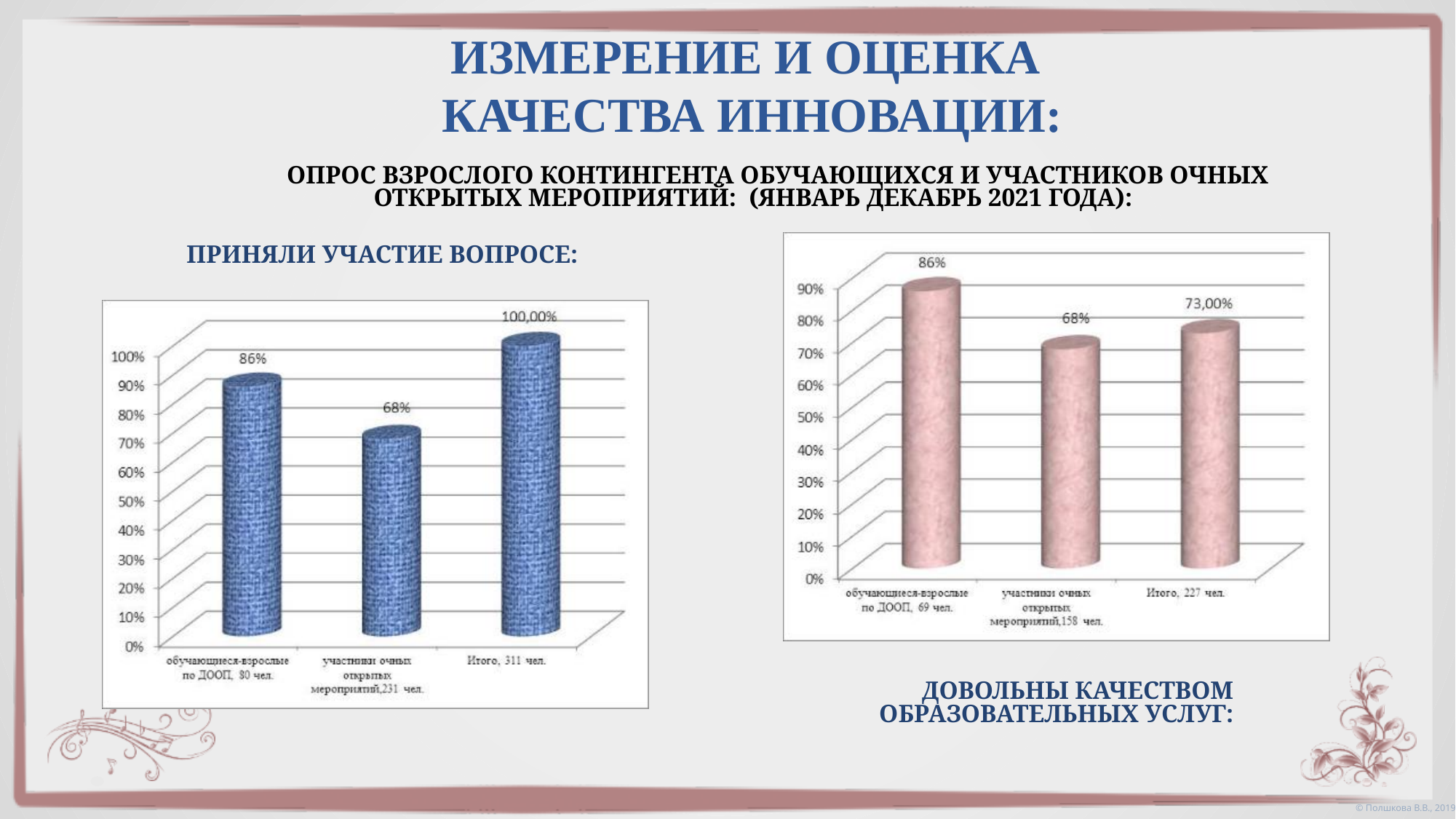
What colour are the bars in the left chart? blue In the right chart, which is larger: the value for 'Итого, 227 чел.' or the value for 'участники очных открытых мероприятий, 158 чел.'? Итого, 227 чел. In the right chart, which category has the highest value? обучающиеся-взрослые по ДООП, 69 чел. In the left chart, which category has the lowest value? участники очных открытых мероприятий, 231 чел. In the right chart, what is the value for 'Итого, 227 чел.'? 73,00% In the right chart, what is the value for 'участники очных открытых мероприятий, 158 чел.'? 68% In the left chart, what is the difference between the values for 'обучающиеся-взрослые по ДООП' and 'участники очных открытых мероприятий'? 18% In the right chart, is the value for 'Итого, 227 чел.' greater or less than 80%? less What kind of chart is the right chart? bar chart In the left chart, what is the value for 'обучающиеся-взрослые по ДООП, 80 чел.'? 86% How many categories are shown in the left chart? 3 In the left chart, what is the value for 'Итого, 311 чел.'? 100,00%